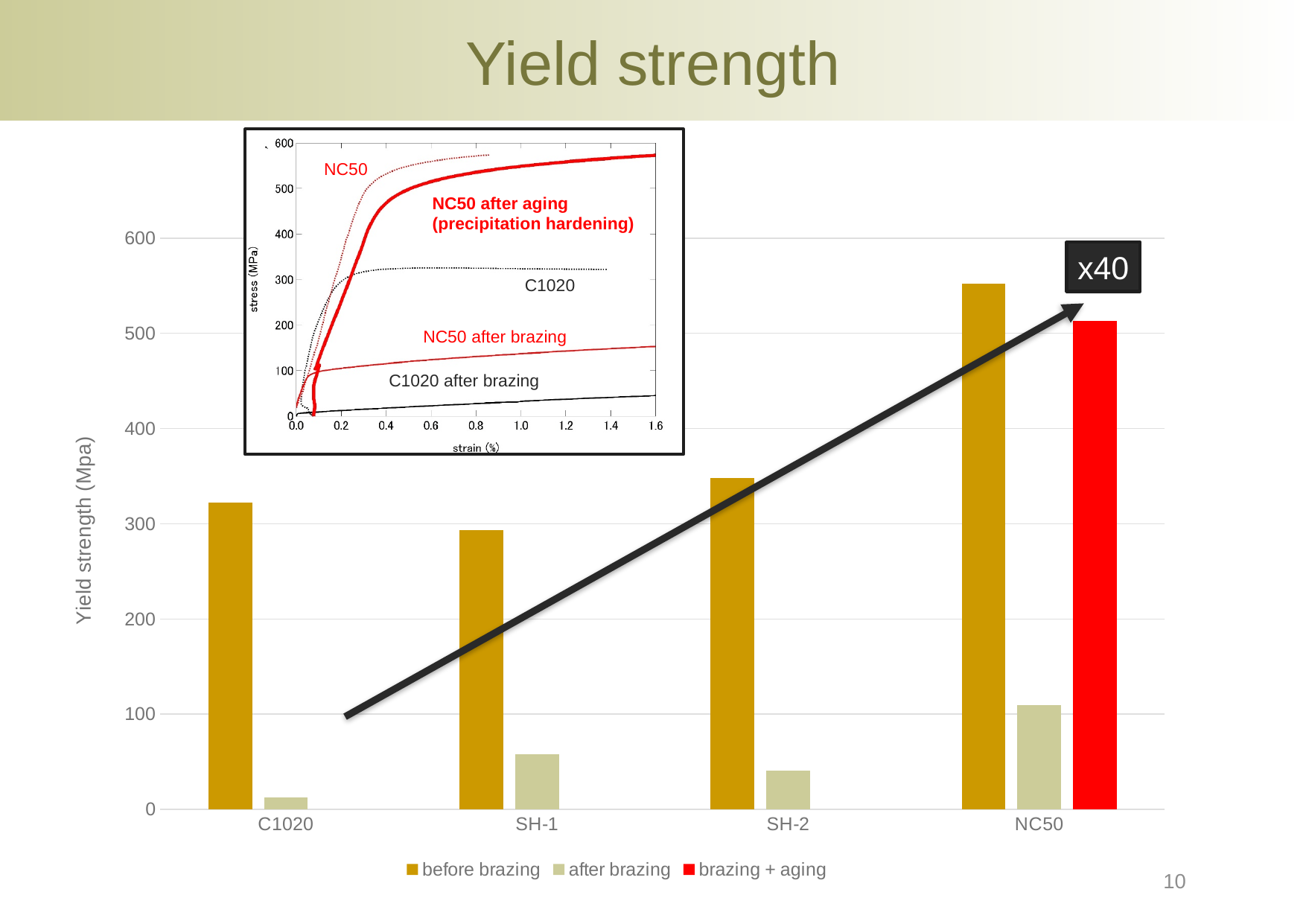
In the main bar chart, which category has the highest 'before brazing' value? NC50 How many series does the legend of the main bar chart list? 3 In the main bar chart, which is larger: the 'before brazing' value for SH-2 or for SH-1? SH-2 In the main bar chart, which is larger for NC50: the 'before brazing' value or the 'brazing + aging' value? before brazing In the main bar chart, is the 'before brazing' value for NC50 greater or less than 500? greater In the main bar chart, is the 'brazing + aging' value for NC50 greater or less than 500? greater In the main bar chart, is the 'after brazing' value for NC50 greater or less than 100? greater What kind of chart is the main chart on the slide? bar chart In the main bar chart, which category has the lowest 'after brazing' value? C1020 What is the y-axis label of the main bar chart? Yield strength (Mpa) How many categories are shown on the x axis of the main bar chart? 4